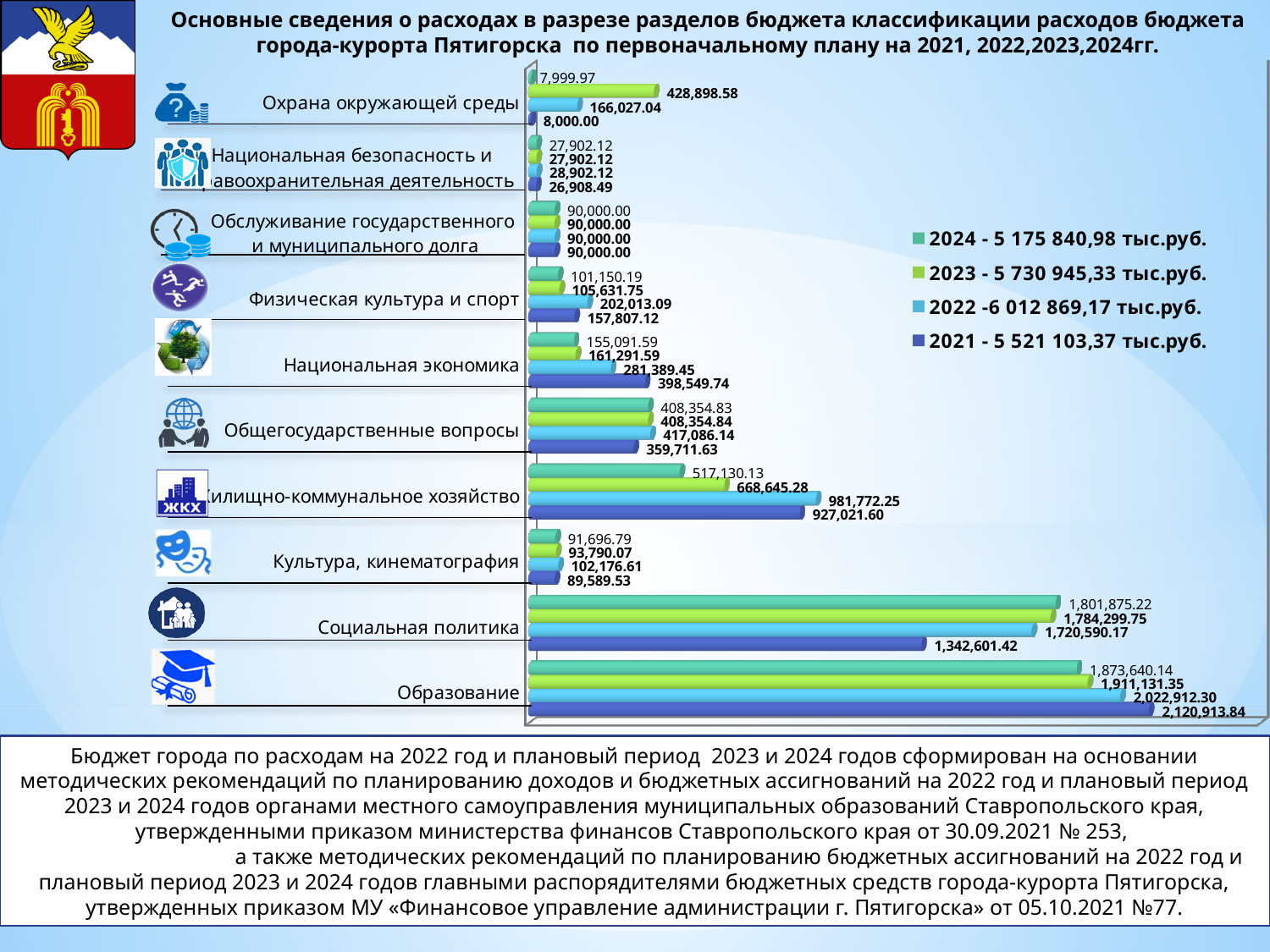
Which category has the highest value for 2022? Образование For Жилищно-коммунальное хозяйство, which year has the larger value, 2022 or 2021? 2022 What is the value for Охрана окружающей среды in 2023? 428,898.58 What is the value for Жилищно-коммунальное хозяйство in 2022? 981,772.25 According to the legend, what is the total for 2023? 5 730 945,33 тыс.руб. How many budget sections (categories) are shown in the chart? 10 What is the value for Образование in 2021? 2,120,913.84 What is the value for Социальная политика in 2024? 1,801,875.22 How many series does the legend list? 4 Which category has the lowest value for 2021? Охрана окружающей среды What kind of chart is shown on the slide? bar chart What is the difference between the 2021 and 2024 values for Образование? 247,273.70